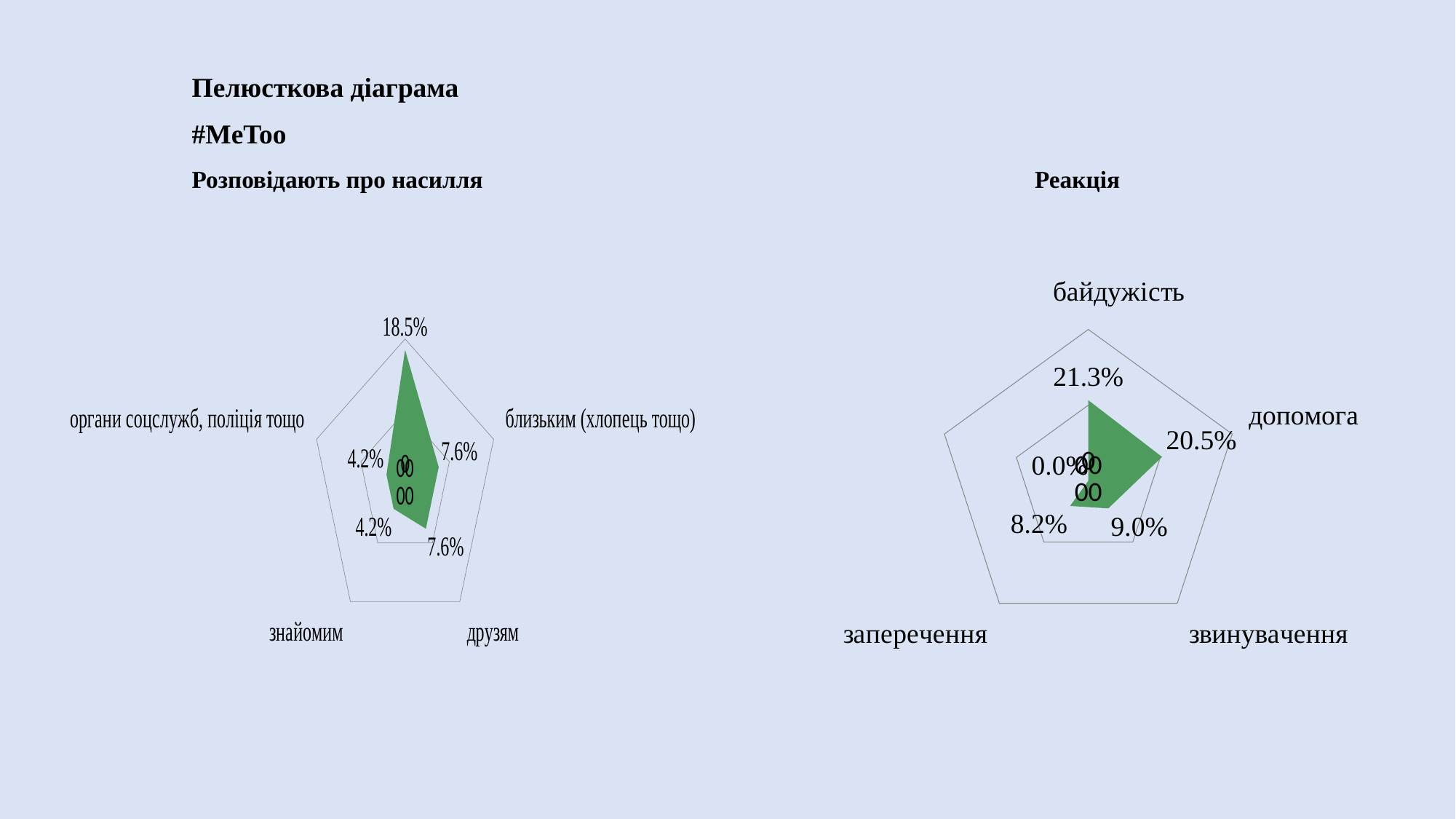
In the 'Розповідають про насилля' chart, what is the value for знайомим? 4.2% In the 'Реакція' chart, what is the value for допомога? 20.5% In the 'Розповідають про насилля' chart, what is the value for близьким (хлопець тощо)? 7.6% How many axes (categories) does the 'Розповідають про насилля' radar chart have? 5 In the 'Розповідають про насилля' chart, what is the largest value shown? 18.5% In the 'Реакція' chart, which is larger, the value for звинувачення or the value for заперечення? звинувачення In the 'Реакція' chart, what is the value for байдужість? 21.3% What kind of chart is the 'Реакція' chart? radar chart In the 'Реакція' chart, what is the value for звинувачення? 9.0% In the 'Розповідають про насилля' chart, what is the value for органи соцслужб, поліція тощо? 4.2% In the 'Реакція' chart, what is the difference between the values for допомога and звинувачення? 11.5% In the 'Реакція' chart, what is the value for заперечення? 8.2%